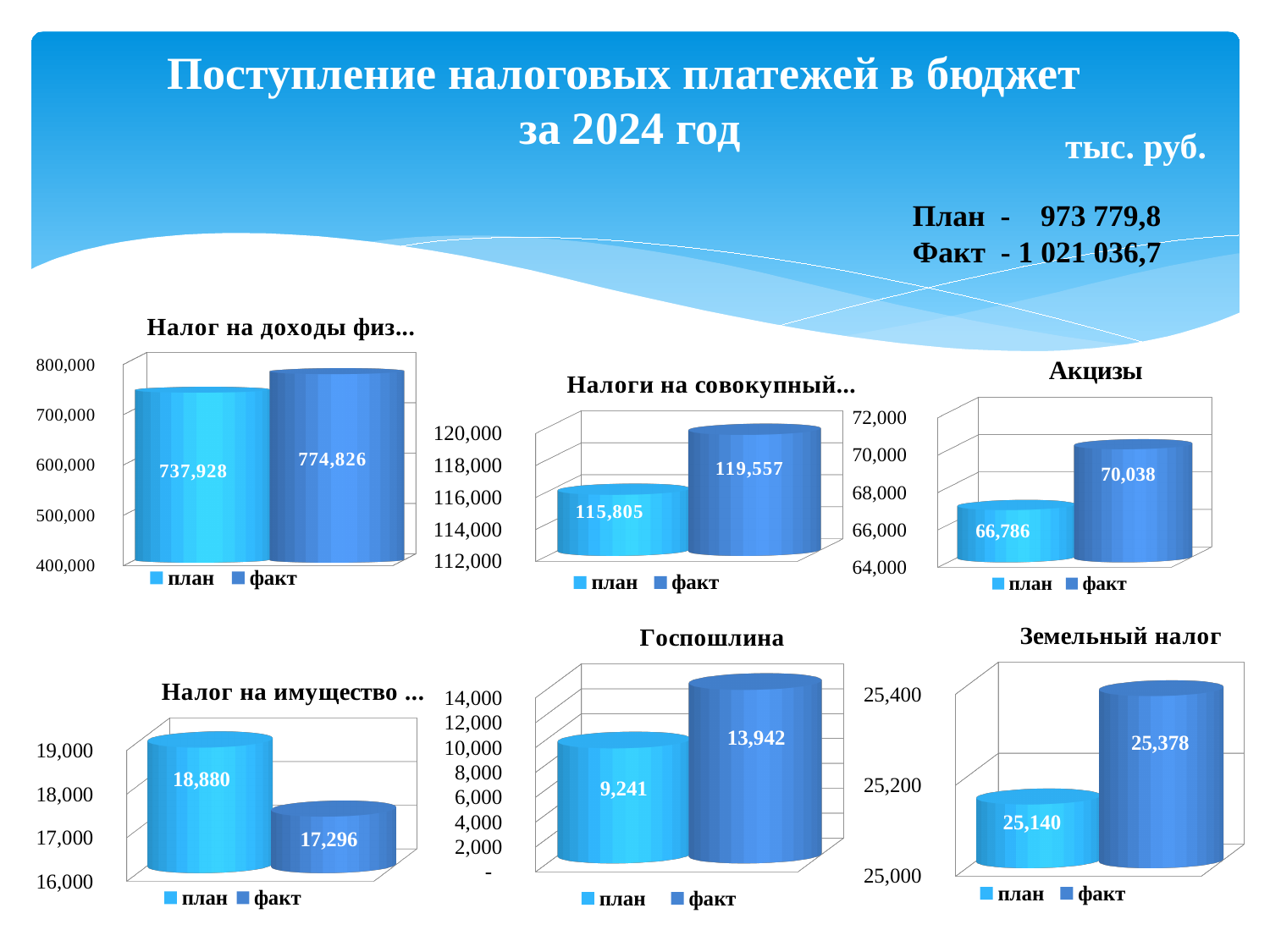
How many series does the legend of the "Земельный налог" chart list? 2 In the "Земельный налог" chart, what is the value for факт? 25,378 In the "Налог на доходы физ..." chart, what is the value for план? 737,928 How many charts are shown on the slide? 6 In the "Налог на доходы физ..." chart, is the value for факт greater or less than 700,000? greater In the "Налоги на совокупный..." chart, what is the difference between факт and план? 3,752 In the "Акцизы" chart, what is the value for факт? 70,038 What kind of chart is the "Госпошлина" chart? bar chart In the "Акцизы" chart, which bar is the lowest? план In the "Госпошлина" chart, what is the value for план? 9,241 In the "Госпошлина" chart, what is the difference between факт and план? 4,701 In the "Налог на имущество ..." chart, which bar is higher, план or факт? план